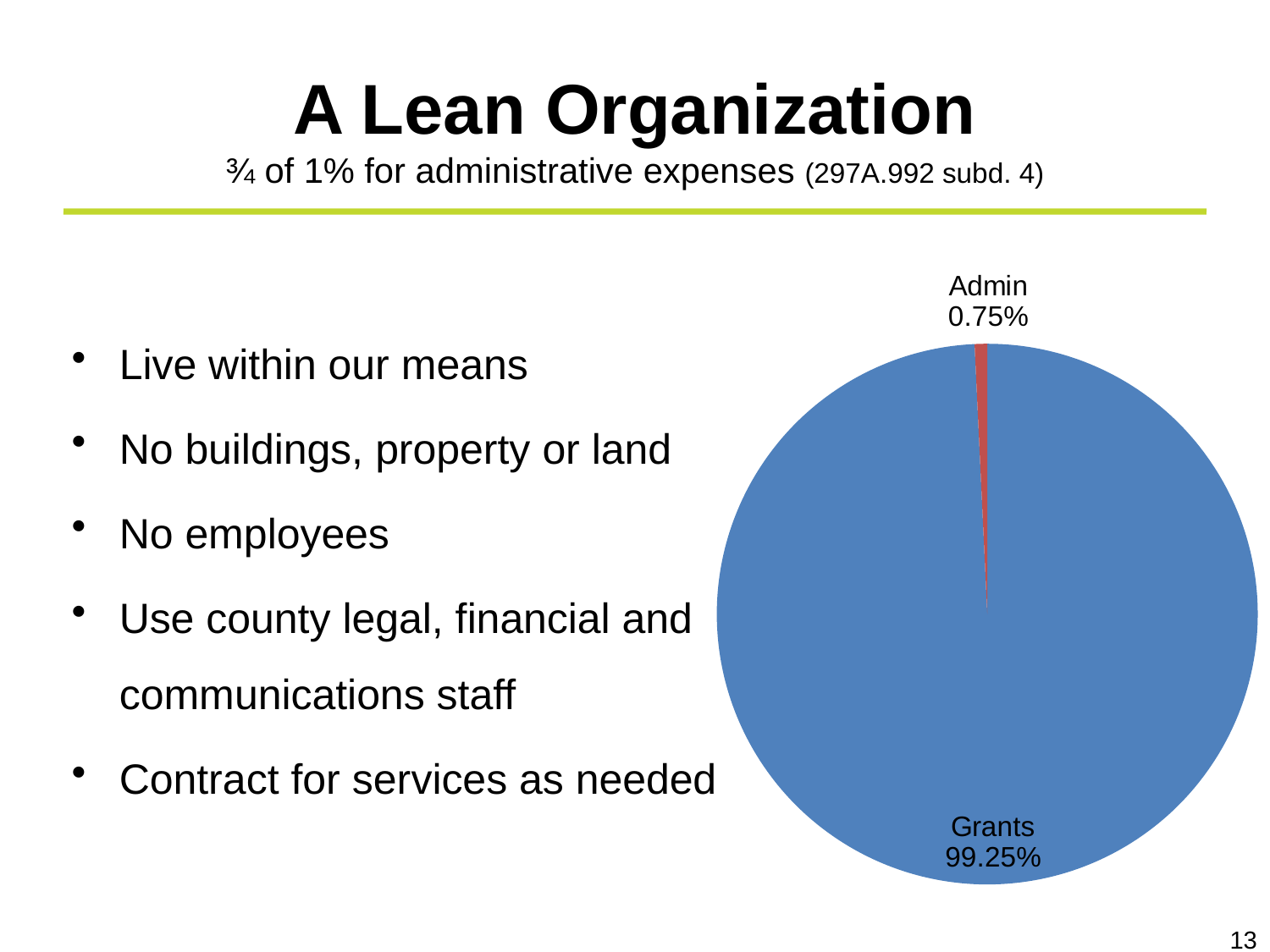
What share of the pie does Admin represent? 0.75% What colour is the Grants slice of the pie? blue Which is larger, the Grants slice or the Admin slice? Grants What share of the pie does Grants represent? 99.25% How many slices does the pie chart have? 2 What is the total of the two slices shown in the pie chart? 100% What kind of chart is shown on the slide? pie chart What colour is the Admin slice of the pie? red What is the difference between the Grants share and the Admin share? 98.50% Which slice of the pie is the largest? Grants Which slice of the pie is the smallest? Admin